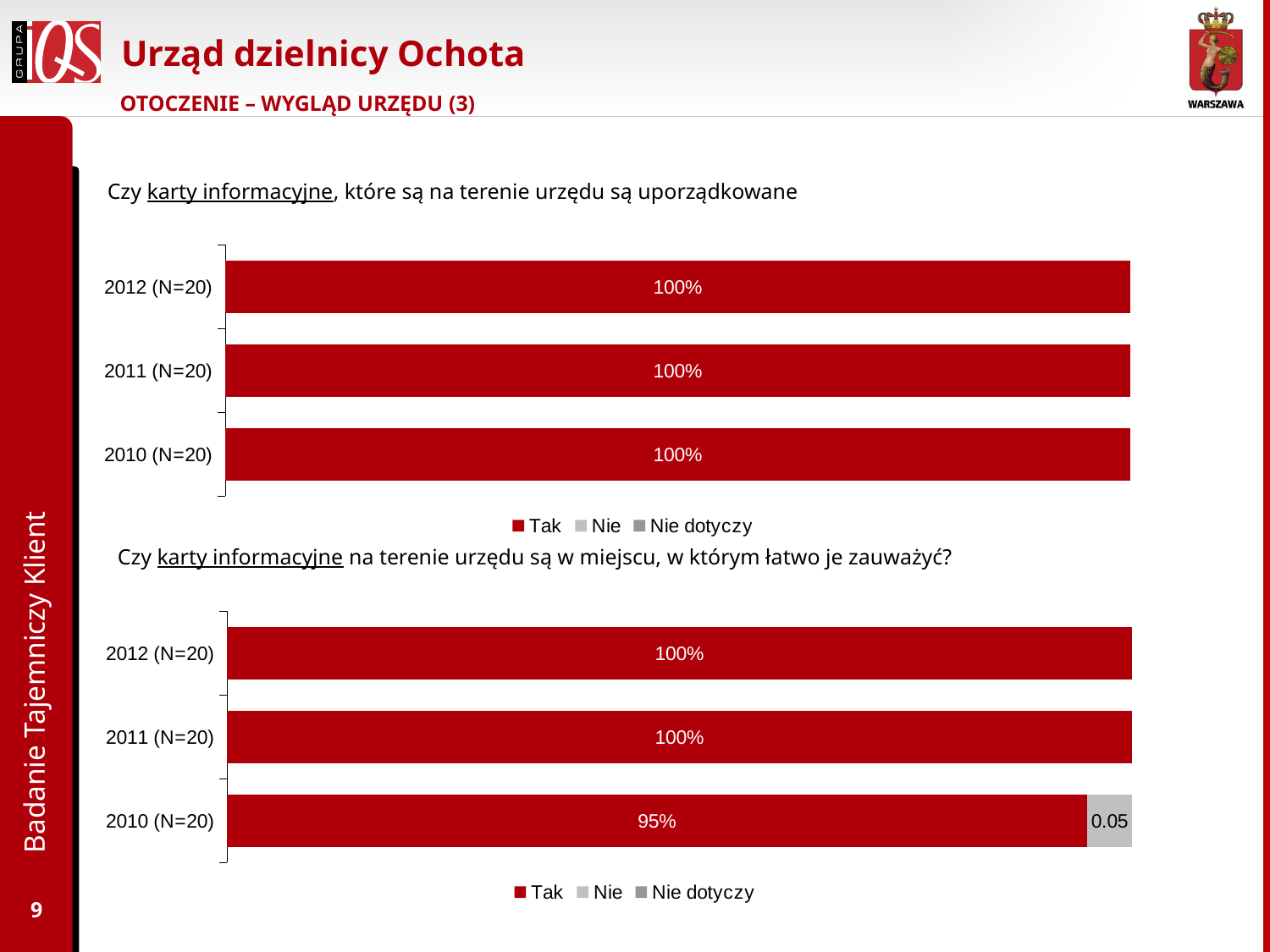
In the bottom chart, what is the difference between the 'Tak' value for 2012 (N=20) and for 2010 (N=20)? 5% In the bottom chart, is the 'Tak' value for 2012 (N=20) or for 2010 (N=20) larger? 2012 (N=20) In the bottom chart, which year has the lowest 'Tak' value? 2010 (N=20) What type of chart is the top chart? Bar chart In the bottom chart, what is the 'Tak' value for 2010 (N=20)? 95% How many series does the legend of the bottom chart list? 3 In the bottom chart, what value is printed on the grey segment for 2010 (N=20)? 0.05 In the bottom chart, what is the 'Tak' value for 2011 (N=20)? 100% What are the legend entries of the top chart? Tak, Nie, Nie dotyczy In the top chart, what is the 'Tak' value for 2012 (N=20)? 100% How many year categories are shown in the top chart? 3 In the top chart, what is the 'Tak' value for 2010 (N=20)? 100%